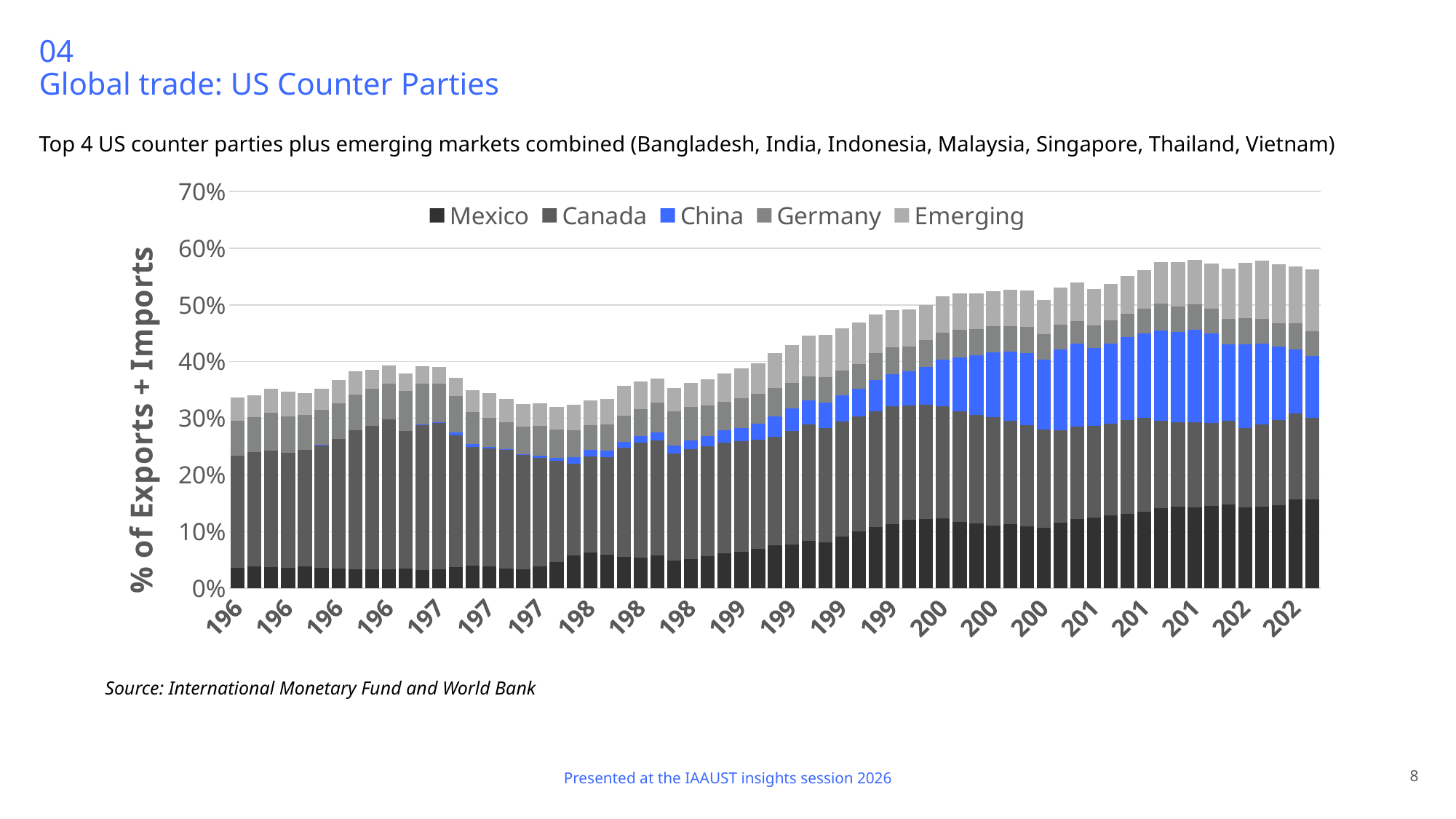
Is the Mexico segment of the rightmost bar greater or less than 10%? greater Which colour represents China in the chart? Blue How many series does the chart's legend list? 5 Is the total of the tallest stacked bar greater or less than 60%? less Is the total of the tallest stacked bar greater or less than 50%? greater Overall, do the stacked bar totals rise or fall from the left of the chart to the right? Rise What is the highest value shown on the vertical axis of the chart? 70% What is the title of the vertical axis of the chart? % of Exports + Imports What kind of chart is shown on the slide? Stacked bar chart